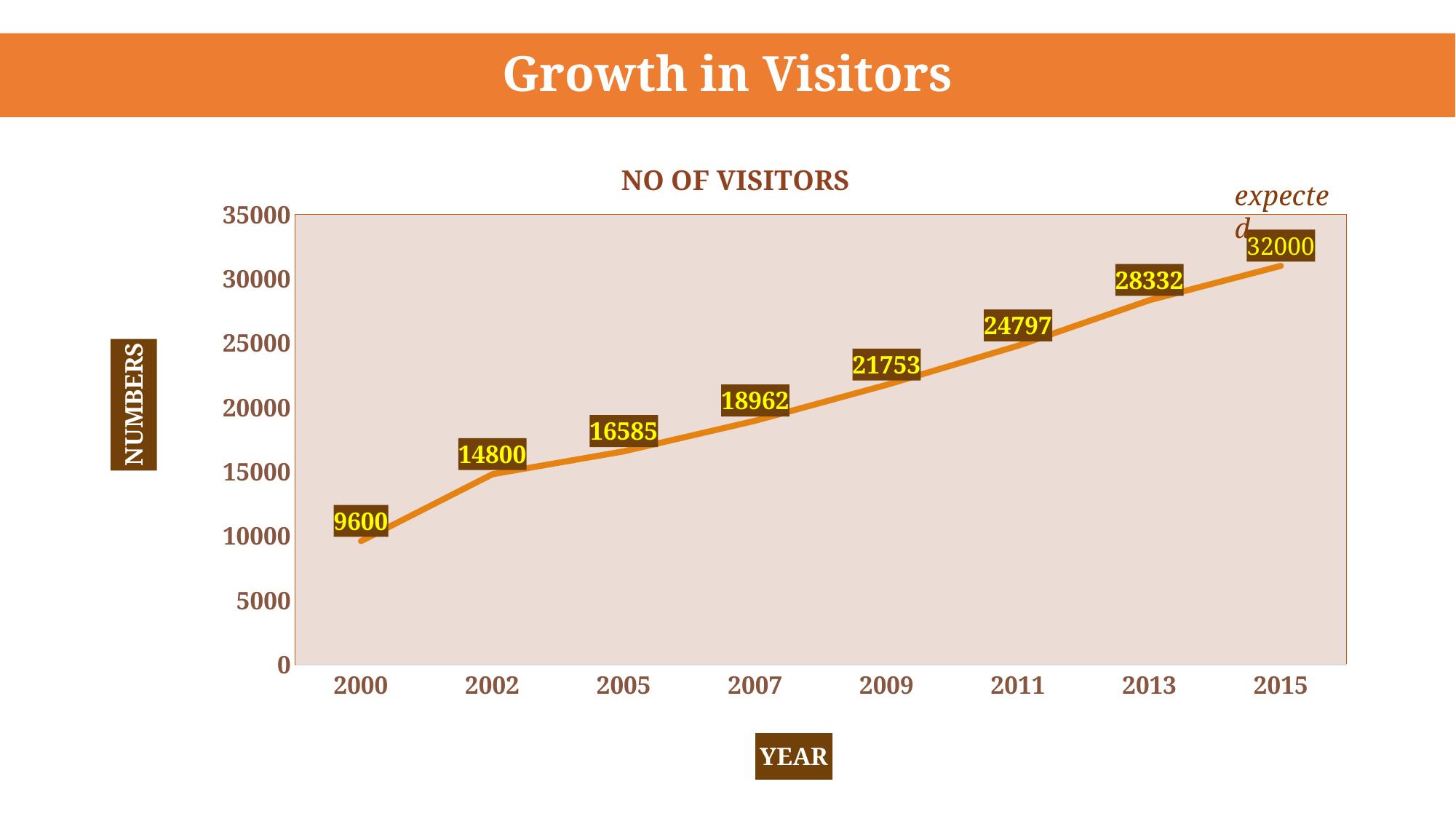
Which year had more visitors, 2007 or 2009? 2009 What is the title of the chart? NO OF VISITORS What is the difference in visitors between 2013 and 2009? 6579 Which year has the lowest number of visitors? 2000 What is the number of visitors in 2005? 16585 What is the difference in visitors between 2002 and 2000? 5200 Which year has the highest number of visitors? 2015 How many years are plotted on the chart? 8 What is the number of visitors in 2011? 24797 What kind of chart is shown? Line chart What is the expected number of visitors in 2015? 32000 Do the visitor numbers rise or fall from 2000 to 2015? Rise